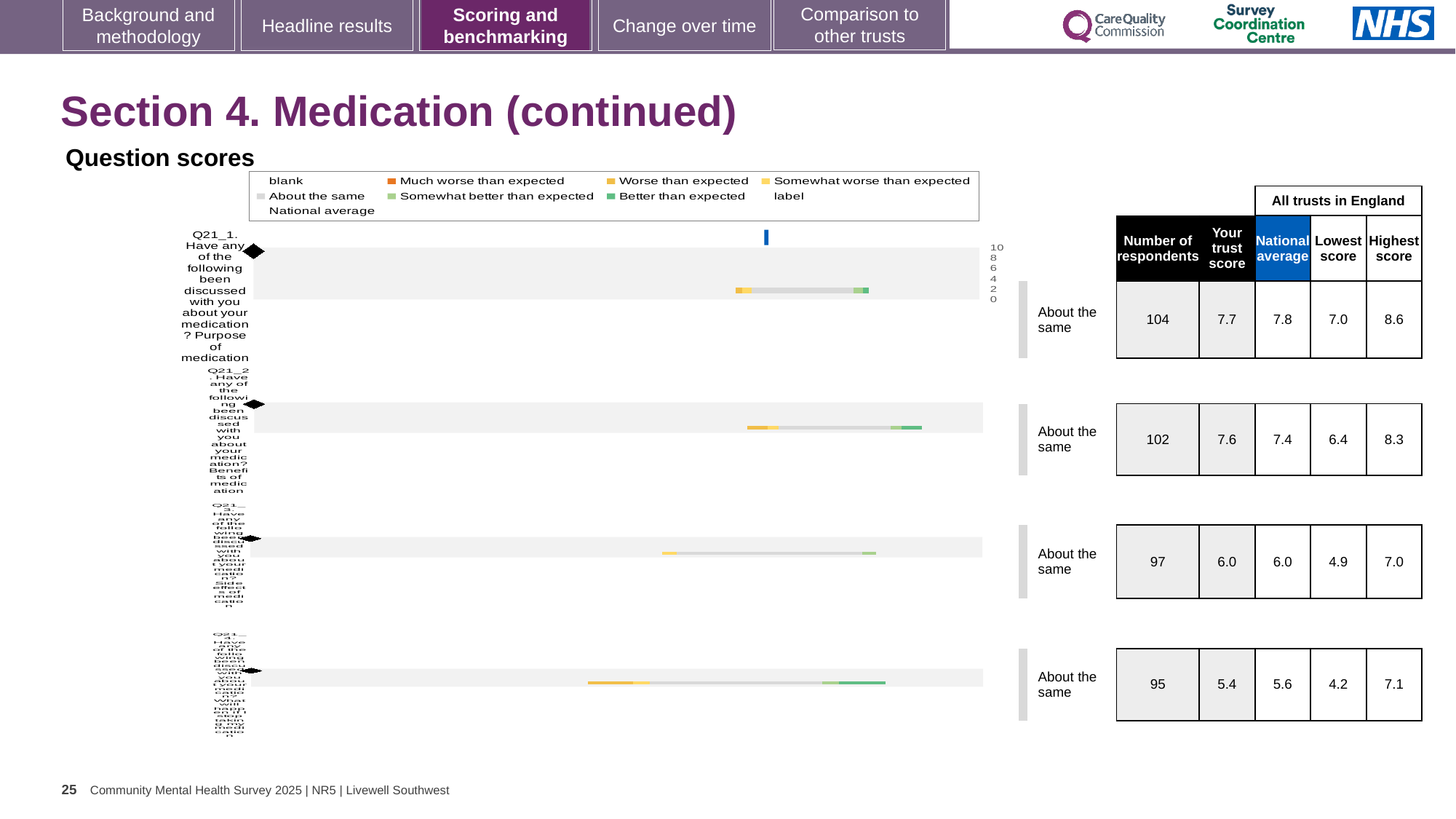
What is the 'Your trust score' for Q21_1 (Purpose of medication)? 7.7 For Q21_1, what is the difference between the highest score and the lowest score across all trusts in England? 1.6 Which question has the highest 'Your trust score'? Q21_1 (Purpose of medication) What kind of chart is used to show the question scores on this slide? bar chart What is the national average for Q21_2 (Benefits of medication)? 7.4 How many respondents are listed for the third question, Q21_3? 97 Which question has the lowest 'Your trust score'? Q21_4 What benchmark category is shown for the fourth question, Q21_4? About the same In the legend, what colour represents 'Much worse than expected'? orange What is the highest score across all trusts in England for Q21_4? 7.1 How many questions (bars) are plotted in the question scores chart? 4 For Q21_2, which is larger: the trust score or the national average? the trust score (7.6)